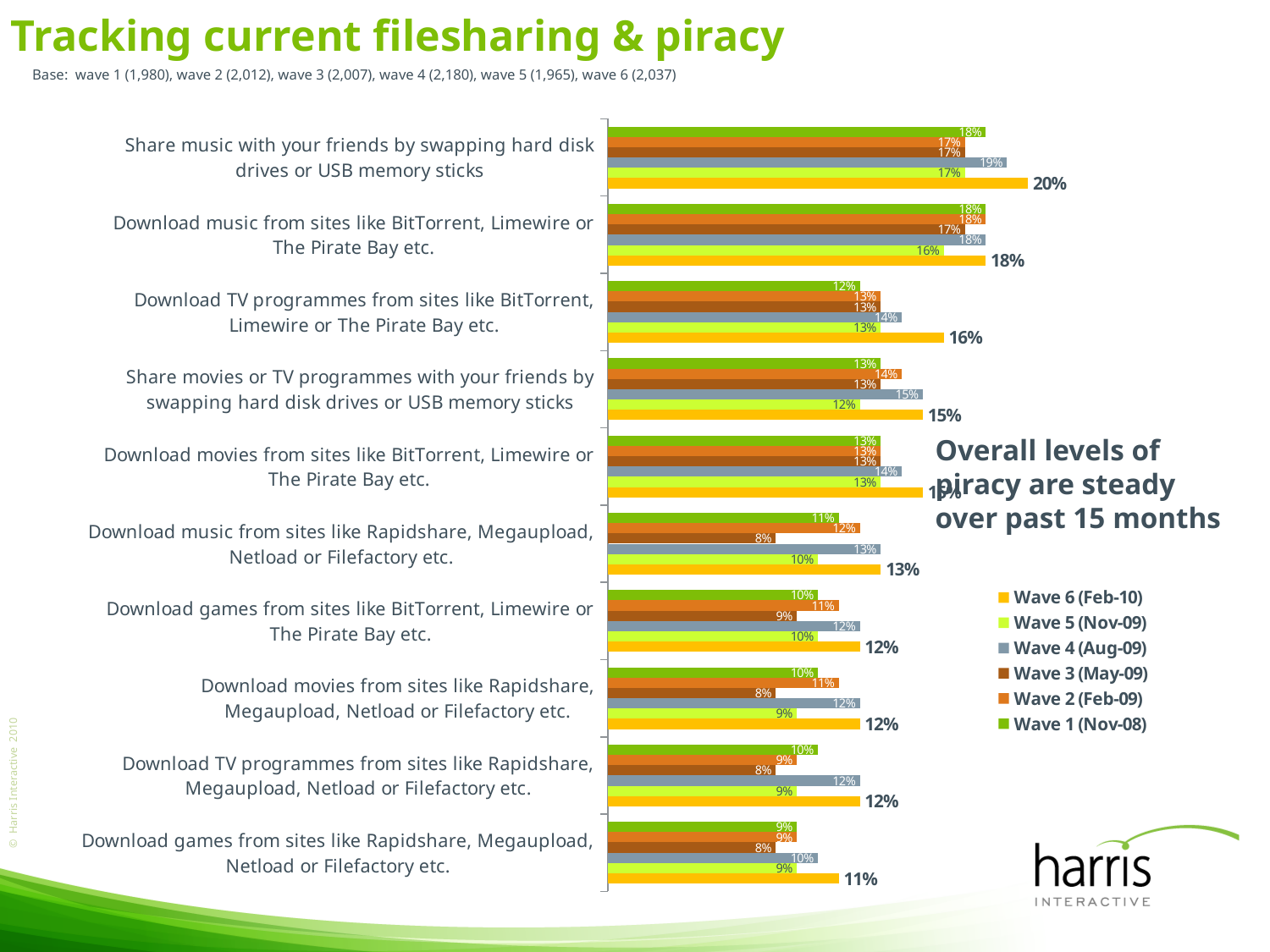
How many activities (categories) are shown in the chart? 10 What is the Wave 3 (May-09) value for 'Download music from sites like Rapidshare, Megaupload, Netload or Filefactory etc.'? 8% What is the Wave 6 (Feb-10) value for 'Share music with your friends by swapping hard disk drives or USB memory sticks'? 20% Which activity has the lowest Wave 6 (Feb-10) value? Download games from sites like Rapidshare, Megaupload, Netload or Filefactory etc. How many series does the legend list? 6 What is the Wave 6 (Feb-10) value for 'Download games from sites like Rapidshare, Megaupload, Netload or Filefactory etc.'? 11% Which activity has the highest Wave 6 (Feb-10) value? Share music with your friends by swapping hard disk drives or USB memory sticks What is the difference between the Wave 6 (Feb-10) values for sharing music by swapping hard disk drives or USB memory sticks and downloading games from sites like Rapidshare? 9 percentage points What is the Wave 4 (Aug-09) value for 'Download TV programmes from sites like BitTorrent, Limewire or The Pirate Bay etc.'? 14% What is the difference between the Wave 6 (Feb-10) and Wave 5 (Nov-09) values for 'Download TV programmes from sites like BitTorrent, Limewire or The Pirate Bay etc.'? 3 percentage points For 'Download music from sites like Rapidshare, Megaupload, Netload or Filefactory etc.', which is larger: the Wave 4 (Aug-09) value or the Wave 5 (Nov-09) value? Wave 4 (Aug-09) What kind of chart is shown on the slide? Bar chart